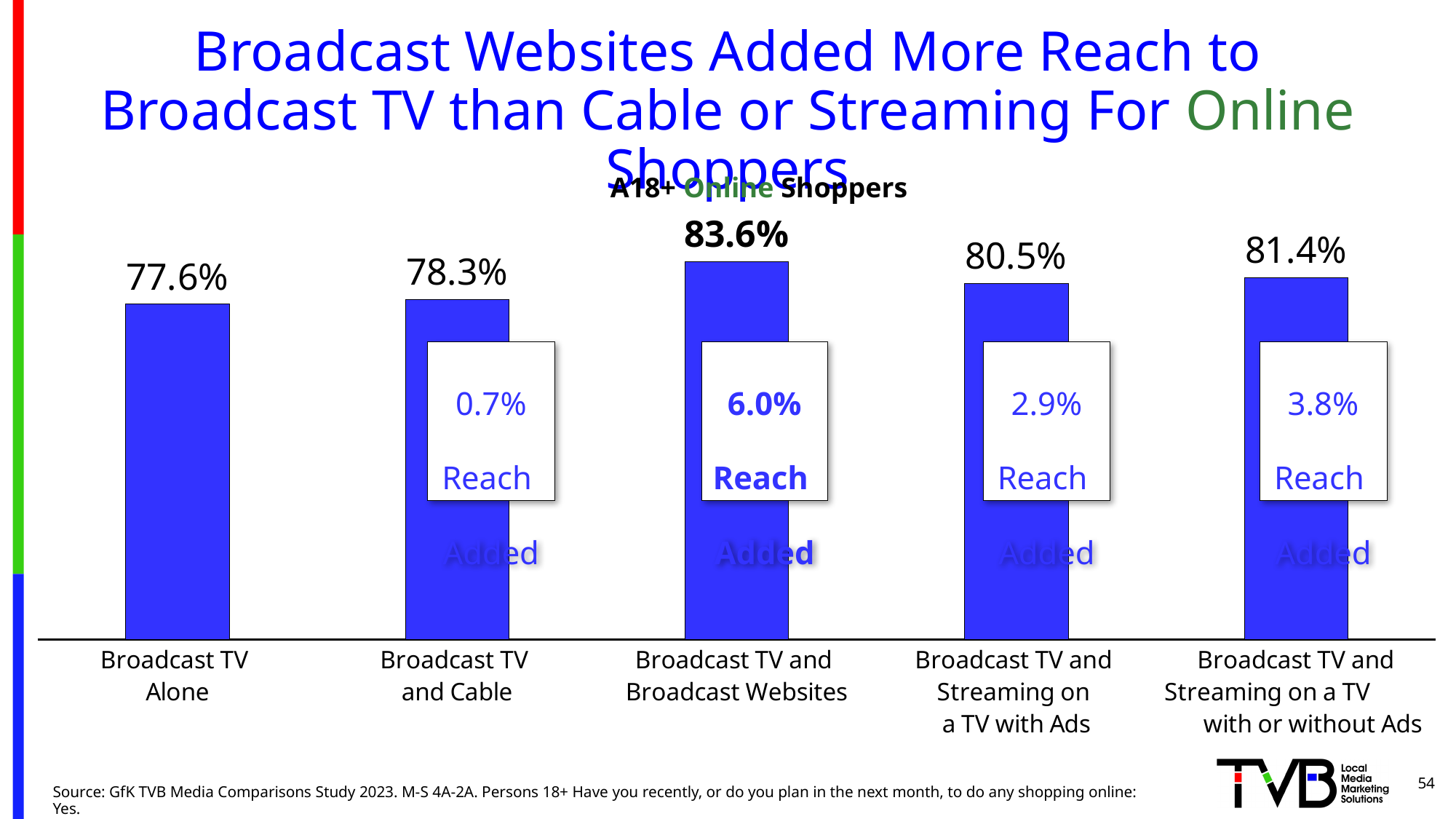
Which is larger: Broadcast TV and Streaming on a TV with Ads or Broadcast TV and Streaming on a TV with or without Ads? Broadcast TV and Streaming on a TV with or without Ads What is the difference between Broadcast TV and Broadcast Websites and Broadcast TV Alone? 6.0% Which category has the highest value? Broadcast TV and Broadcast Websites What kind of chart is shown on the slide? Bar chart How many categories are shown in the chart? 5 What is the value for Broadcast TV and Streaming on a TV with or without Ads? 81.4% Which category has the lowest value? Broadcast TV Alone What is the chart's subtitle above the bars? A18+ Online Shoppers What is the value for Broadcast TV and Streaming on a TV with Ads? 80.5% What is the value for Broadcast TV and Broadcast Websites? 83.6% What is the value for Broadcast TV Alone? 77.6% What is the difference between Broadcast TV and Cable and Broadcast TV Alone? 0.7%